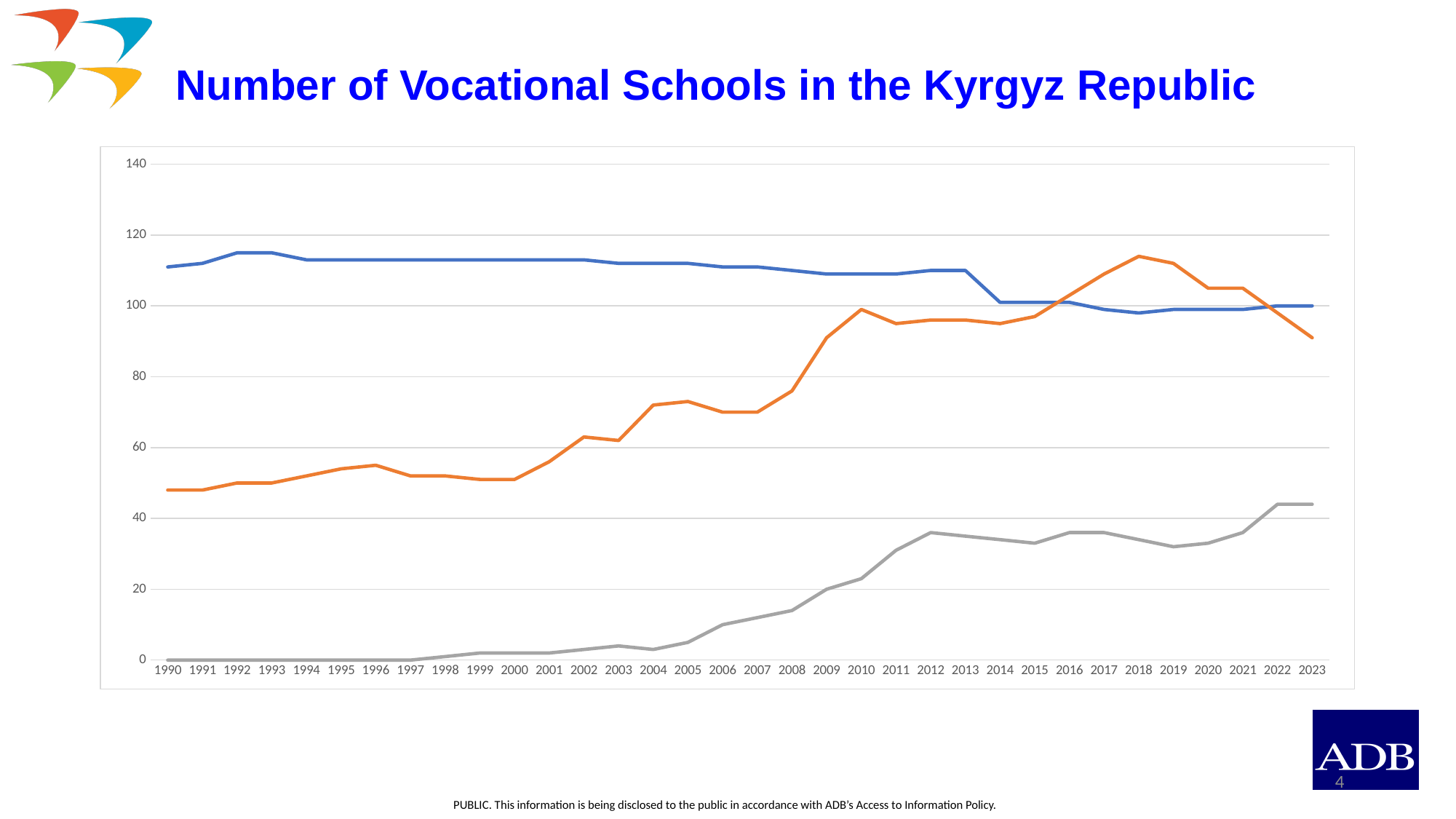
Is the value of the blue line in 1992 greater or less than 100? greater How many lines are plotted on the chart? 3 How many years are shown along the x axis of the chart? 34 In which year does the orange line reach its highest value? 2018 In 1990, which line is higher, the blue line or the orange line? blue line What is the first year shown on the x axis? 1990 Is the value of the orange line in 2018 greater or less than 100? greater Is the value of the gray line in 2023 greater or less than 40? greater What is the title of the chart? Number of Vocational Schools in the Kyrgyz Republic In 2018, which line is higher, the blue line or the orange line? orange line What kind of chart is shown on the slide? line chart